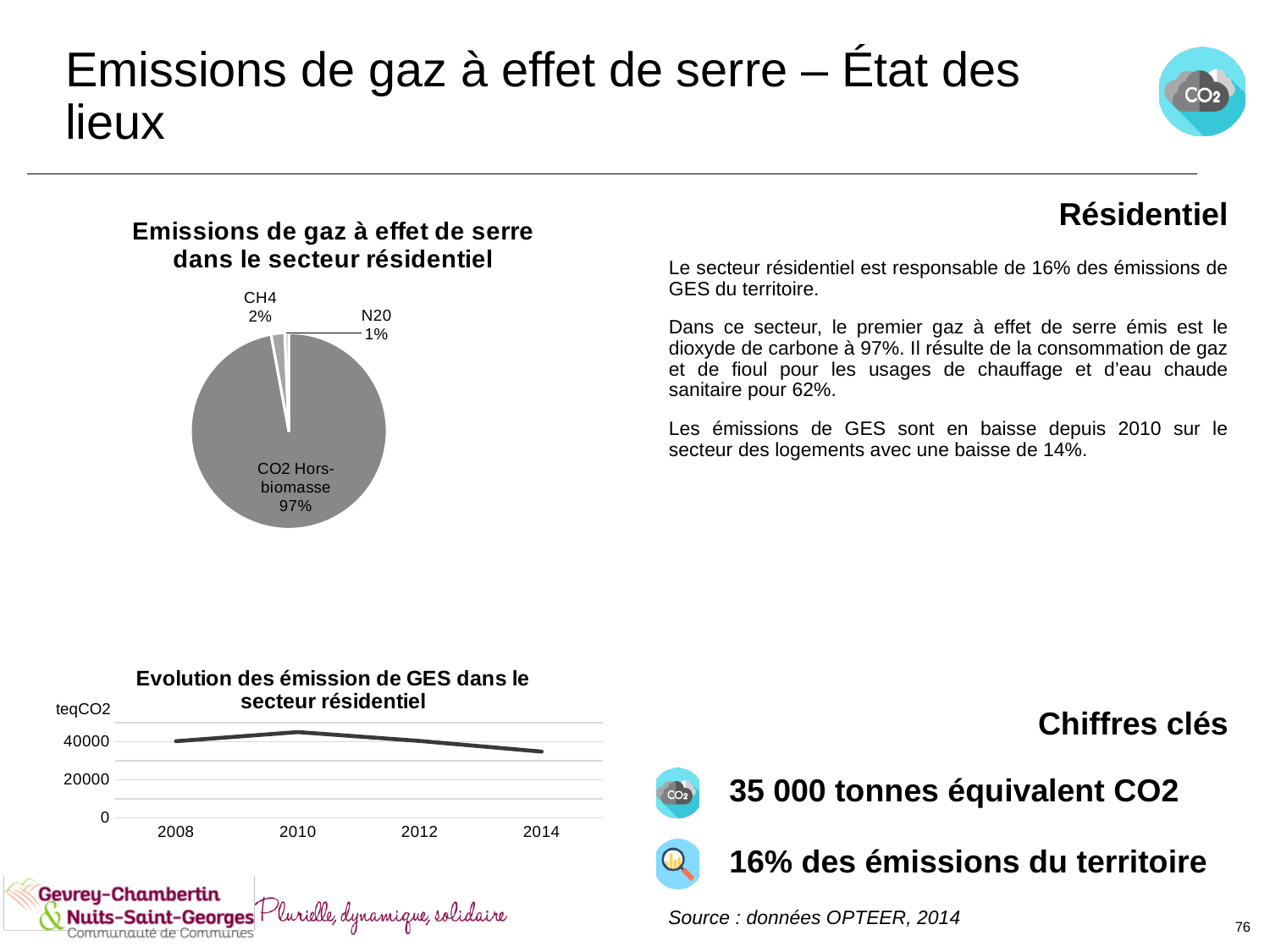
In the pie chart 'Emissions de gaz à effet de serre dans le secteur résidentiel', what is the difference in percentage points between the CH4 share and the N2O share? 1 percentage point In the chart 'Evolution des émission de GES dans le secteur résidentiel', is the value for 2010 greater or less than 40000? greater In the pie chart 'Emissions de gaz à effet de serre dans le secteur résidentiel', which gas has the smallest slice? N2O What kind of chart is 'Evolution des émission de GES dans le secteur résidentiel'? Line chart In the chart 'Evolution des émission de GES dans le secteur résidentiel', how many years are shown on the x axis? 4 In the pie chart 'Emissions de gaz à effet de serre dans le secteur résidentiel', how many slices are there? 3 In the pie chart 'Emissions de gaz à effet de serre dans le secteur résidentiel', what share does CH4 have? 2% In the pie chart 'Emissions de gaz à effet de serre dans le secteur résidentiel', what share does CO2 Hors-biomasse have? 97% In the pie chart 'Emissions de gaz à effet de serre dans le secteur résidentiel', which gas has the largest slice? CO2 Hors-biomasse In the chart 'Evolution des émission de GES dans le secteur résidentiel', is the value for 2014 greater or less than 40000? less In the pie chart 'Emissions de gaz à effet de serre dans le secteur résidentiel', what share does N2O have? 1% In the chart 'Evolution des émission de GES dans le secteur résidentiel', do the values rise or fall from 2010 to 2014? fall